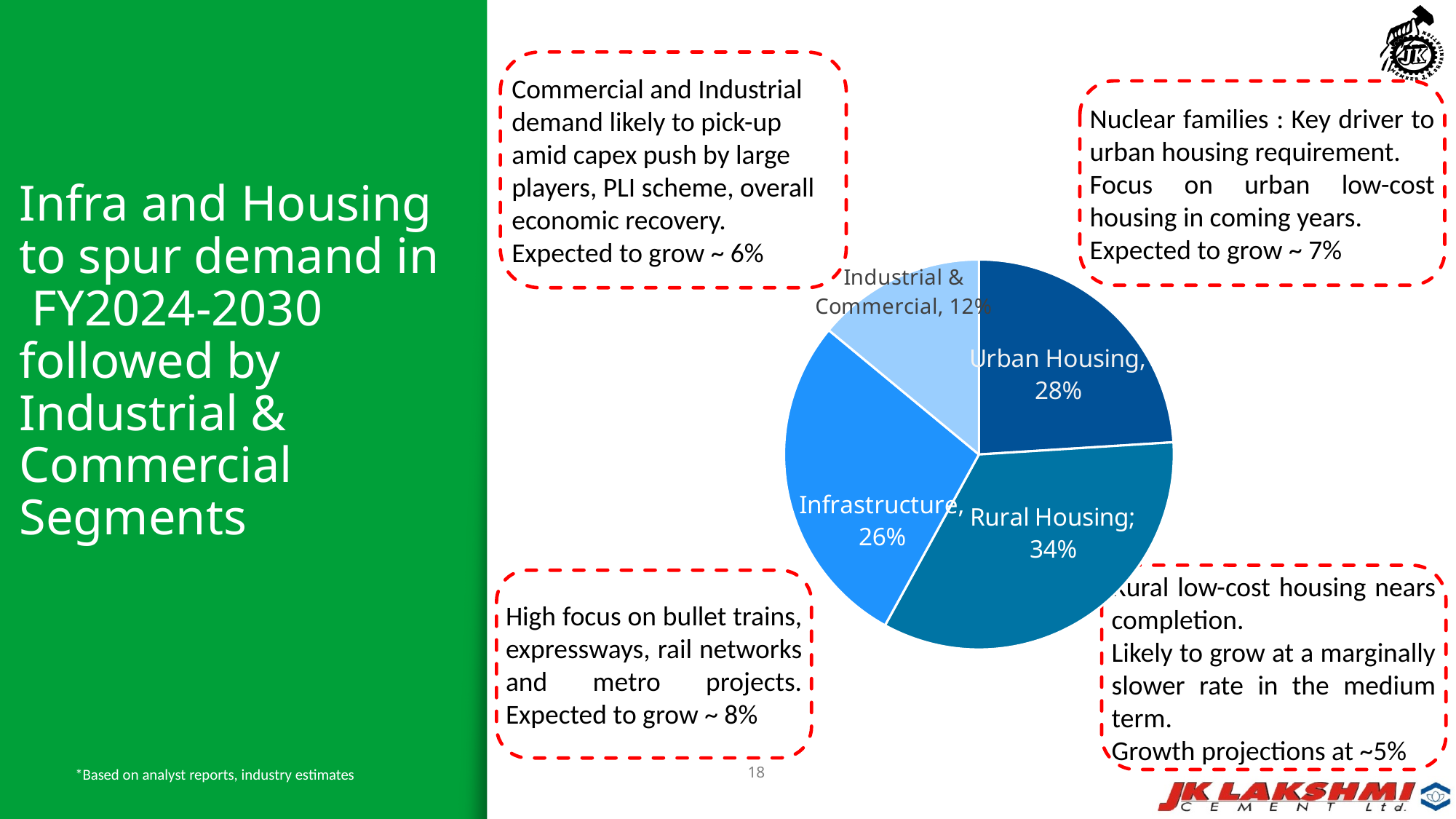
What kind of chart is shown on the slide? pie chart What is the difference between the Rural Housing and Urban Housing shares? 6% What is the difference between the Infrastructure and Industrial & Commercial shares? 14% What is the value shown for Industrial & Commercial? 12% Which segment has the smallest share of the pie? Industrial & Commercial What is the value shown for Infrastructure? 26% What share of the pie does Rural Housing account for? 34% What is the combined share of Urban Housing and Rural Housing? 62% Which segment has the largest share of the pie? Rural Housing How many segments does the pie chart have? 4 What is the value shown for Urban Housing? 28%